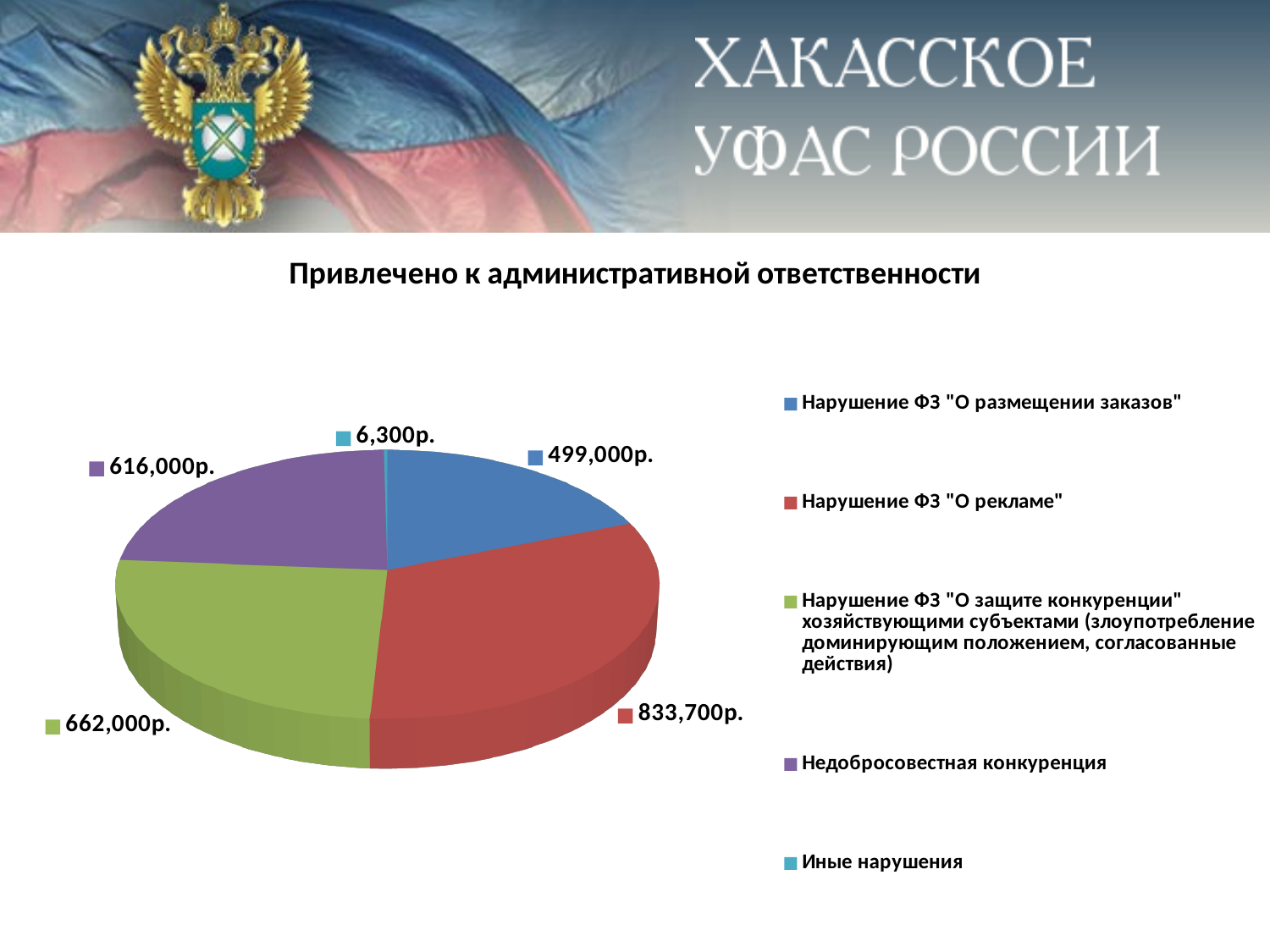
What is the difference between the values for Нарушение ФЗ "О рекламе" and Нарушение ФЗ "О защите конкуренции" хозяйствующими субъектами? 171,700р. What is the value for Недобросовестная конкуренция? 616,000р. How many slices does the pie chart have? 5 What is the title of the chart? Привлечено к административной ответственности Which is larger: the value for Недобросовестная конкуренция or the value for Нарушение ФЗ "О размещении заказов"? Недобросовестная конкуренция What is the value for Иные нарушения? 6,300р. What is the value for Нарушение ФЗ "О рекламе"? 833,700р. Which category has the largest value? Нарушение ФЗ "О рекламе" What type of chart is shown on the slide? Pie chart What colour is the slice for Недобросовестная конкуренция? Purple What is the value for Нарушение ФЗ "О размещении заказов"? 499,000р. Which category has the smallest value? Иные нарушения